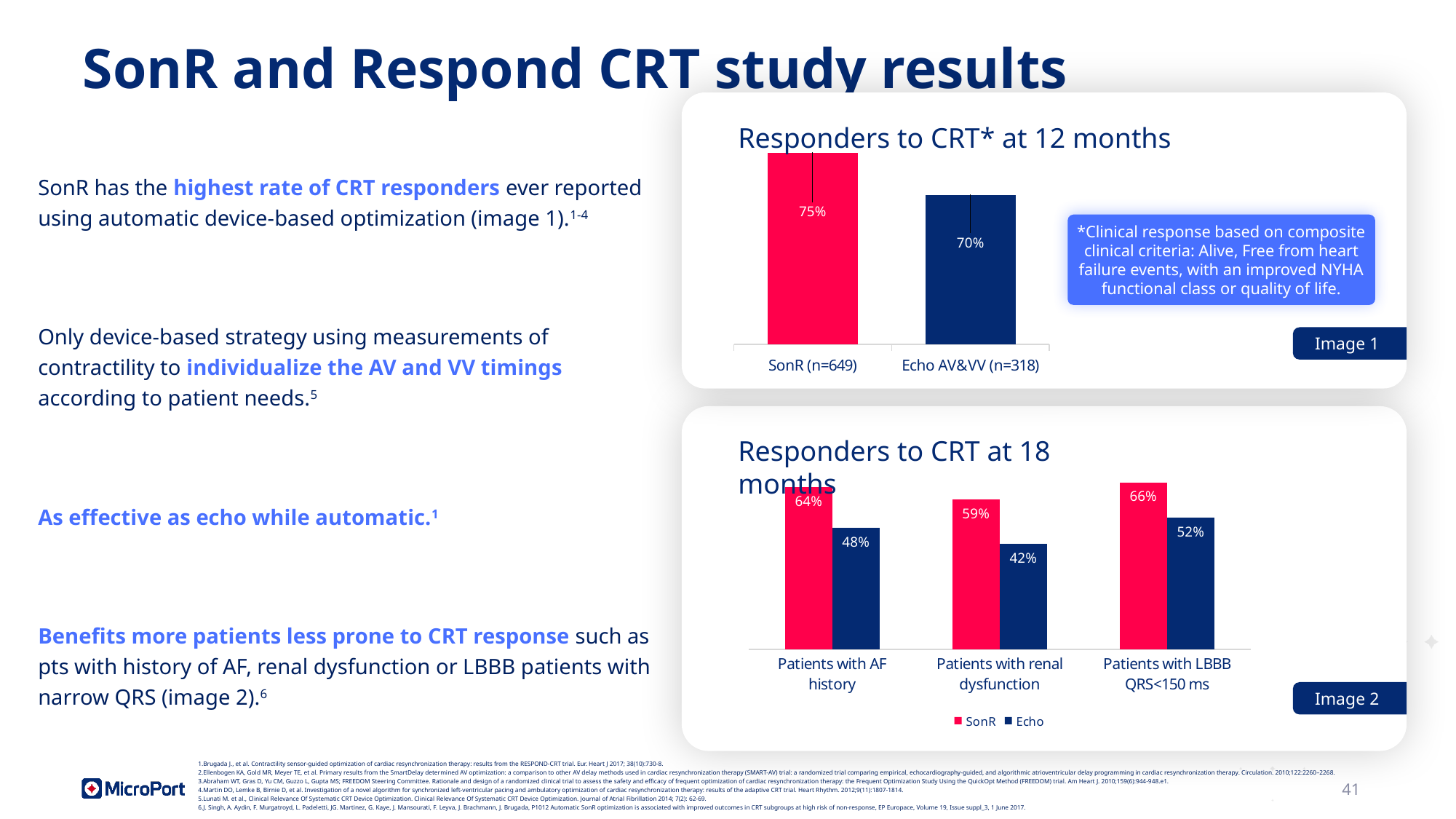
In the 'Responders to CRT at 18 months' chart, what is the Echo value for Patients with LBBB QRS<150 ms? 52% In the 'Responders to CRT* at 12 months' chart, how many bars are plotted? 2 In the 'Responders to CRT* at 12 months' chart, what is the difference between the SonR and Echo AV&VV values? 5% In the 'Responders to CRT* at 12 months' chart, what is the value for SonR (n=649)? 75% In the 'Responders to CRT at 18 months' chart, which category has the highest SonR value? Patients with LBBB QRS<150 ms In the 'Responders to CRT at 18 months' chart, which is larger for Patients with renal dysfunction: SonR or Echo? SonR In the 'Responders to CRT at 18 months' chart, which category has the lowest Echo value? Patients with renal dysfunction What type of chart is the 'Responders to CRT at 18 months' chart? Bar chart In the 'Responders to CRT* at 12 months' chart, what is the value for Echo AV&VV (n=318)? 70% In the 'Responders to CRT at 18 months' chart, what is the SonR value for Patients with renal dysfunction? 59% In the 'Responders to CRT at 18 months' chart, what is the difference between the SonR and Echo values for Patients with AF history? 16% How many series does the legend of the 'Responders to CRT at 18 months' chart list? 2